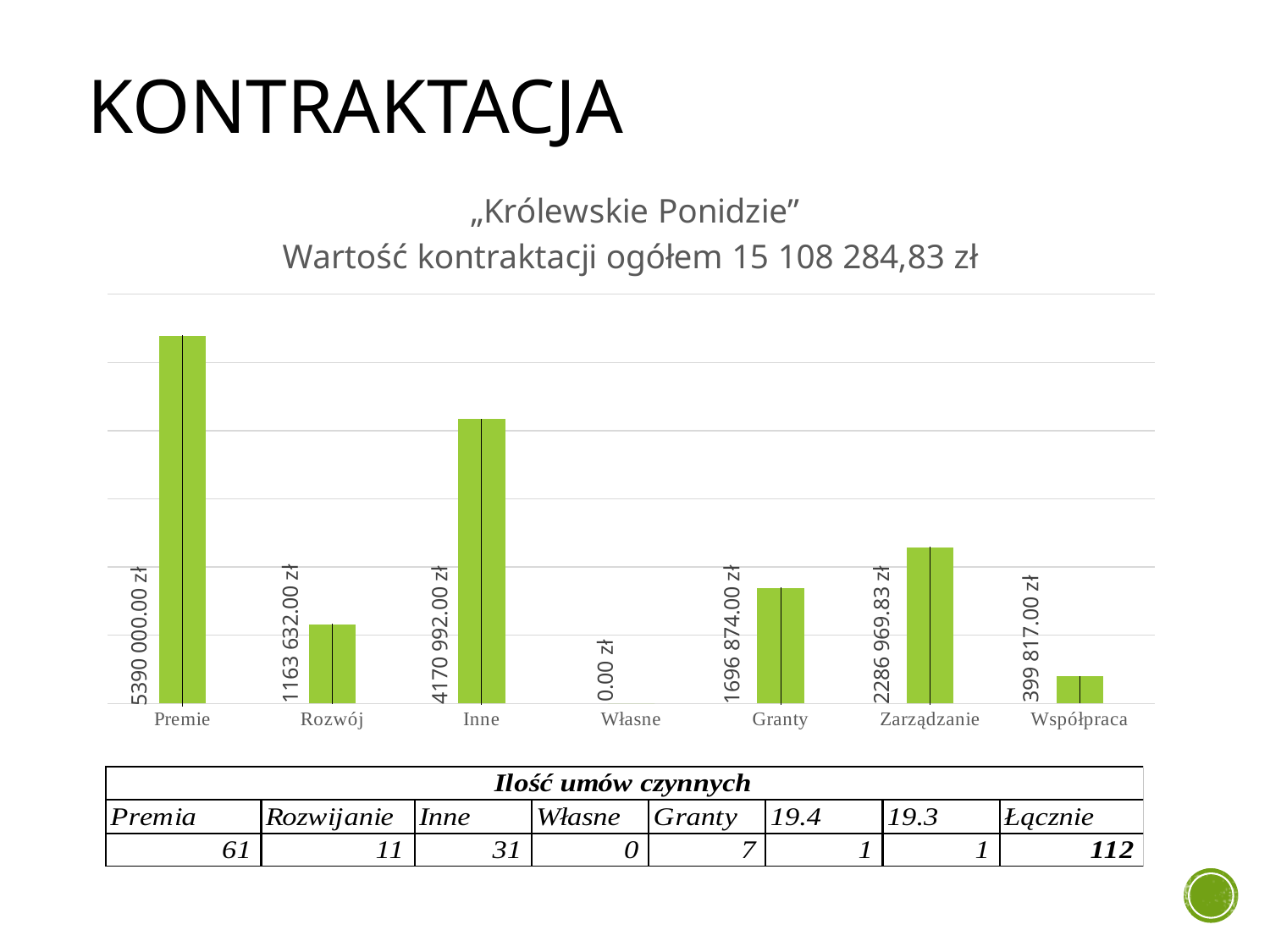
What is the value for Zarządzanie? 2286 969.83 zł What is the value for Współpraca? 399 817.00 zł What is the difference between the values for Premie and Inne? 1219 008.00 zł What is the value for Premie? 5390 000.00 zł What is the value for Własne? 0.00 zł What is the difference between the values for Zarządzanie and Granty? 590 095.83 zł How many categories are shown on the x axis of the chart? 7 What kind of chart is shown on the slide? bar chart Which category has the highest value? Premie Which category has the lowest value? Własne Which is larger, the value for Rozwój or the value for Granty? Granty What is the total contract value stated in the chart's subtitle? 15 108 284,83 zł